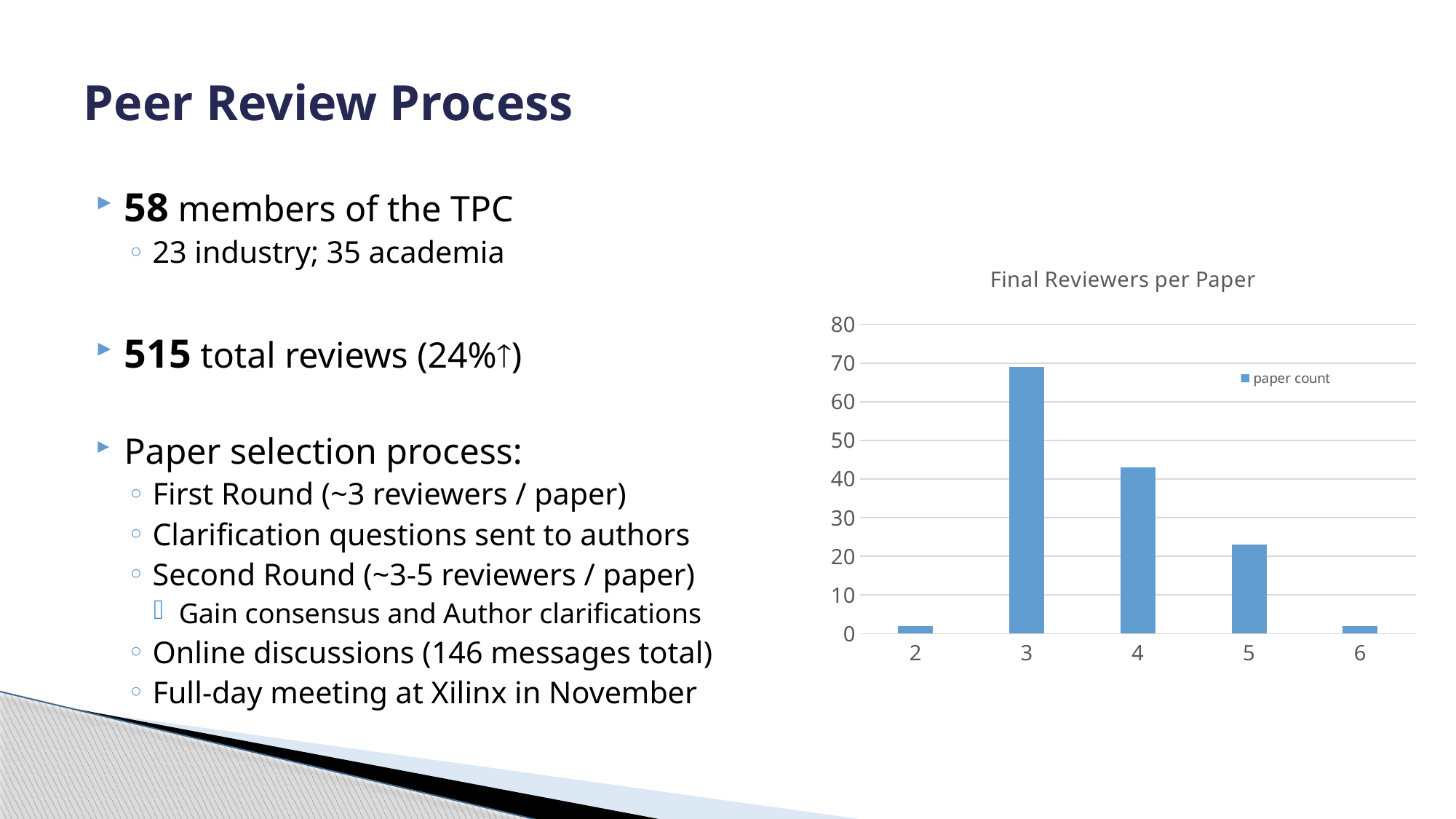
How many series does the chart legend list? 1 How many categories are shown on the x axis of the chart? 5 Is the paper count for category 6 greater or less than 10? less What is the name of the series shown in the chart legend? paper count Is the paper count for category 5 greater or less than 20? greater Which has a larger paper count, category 4 or category 5? 4 What kind of chart is shown under the title "Final Reviewers per Paper"? bar chart Which category has the highest paper count? 3 Is the paper count for category 3 greater or less than 60? greater What is the title of the chart on the slide? Final Reviewers per Paper From category 3 to category 6, do the paper counts rise or fall? fall